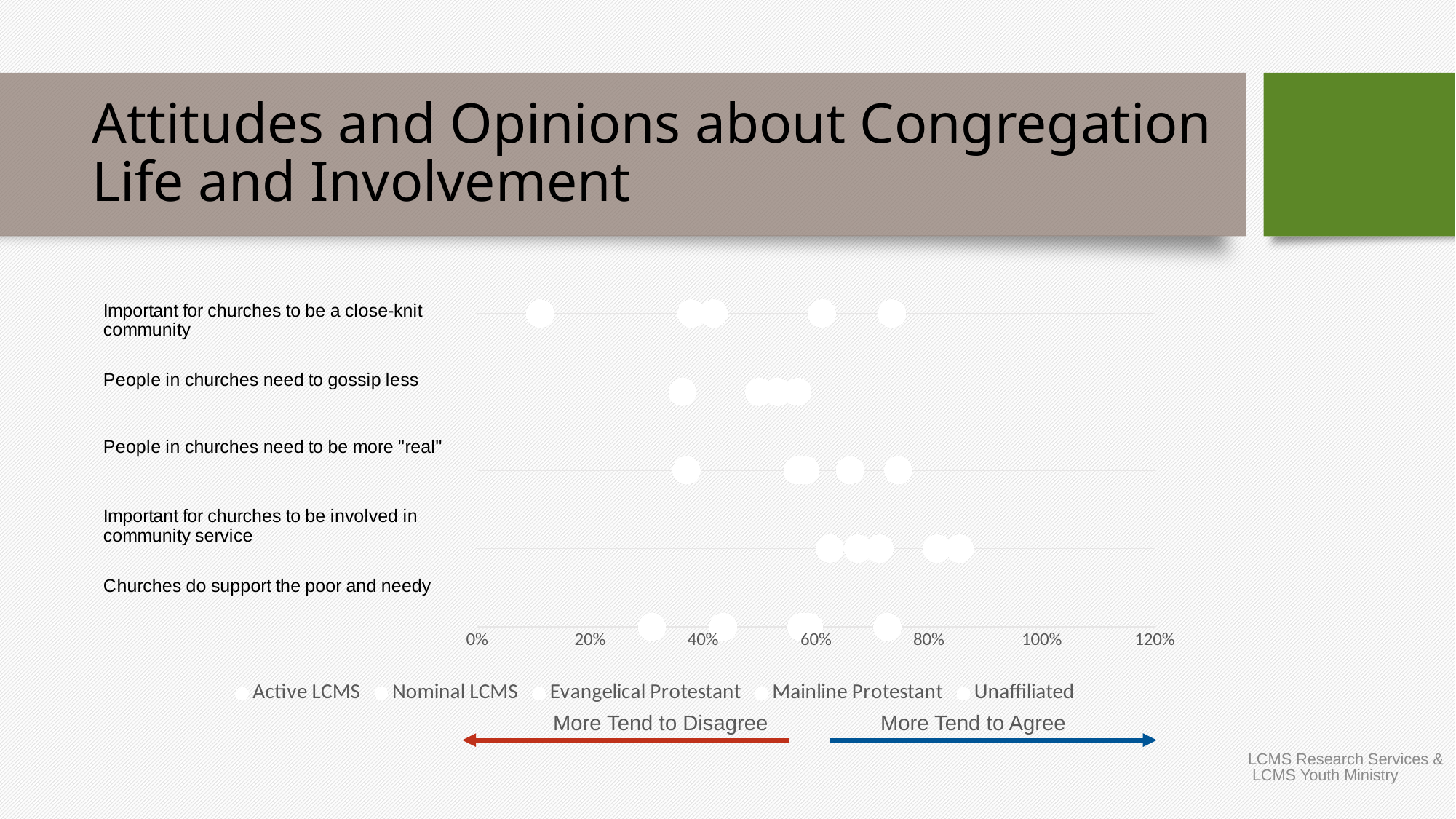
What kind of chart is shown on the slide? dot plot Is the lowest value for 'Important for churches to be a close-knit community' greater or less than 20%? less Is the lowest value for 'Churches do support the poor and needy' greater or less than 20%? greater How many series does the legend list? 5 Is the highest value for 'Important for churches to be a close-knit community' greater or less than 80%? less Which legend entry appears first in the legend? Active LCMS How many statements (categories) are listed on the chart? 5 What is the highest value shown on the x axis? 120%